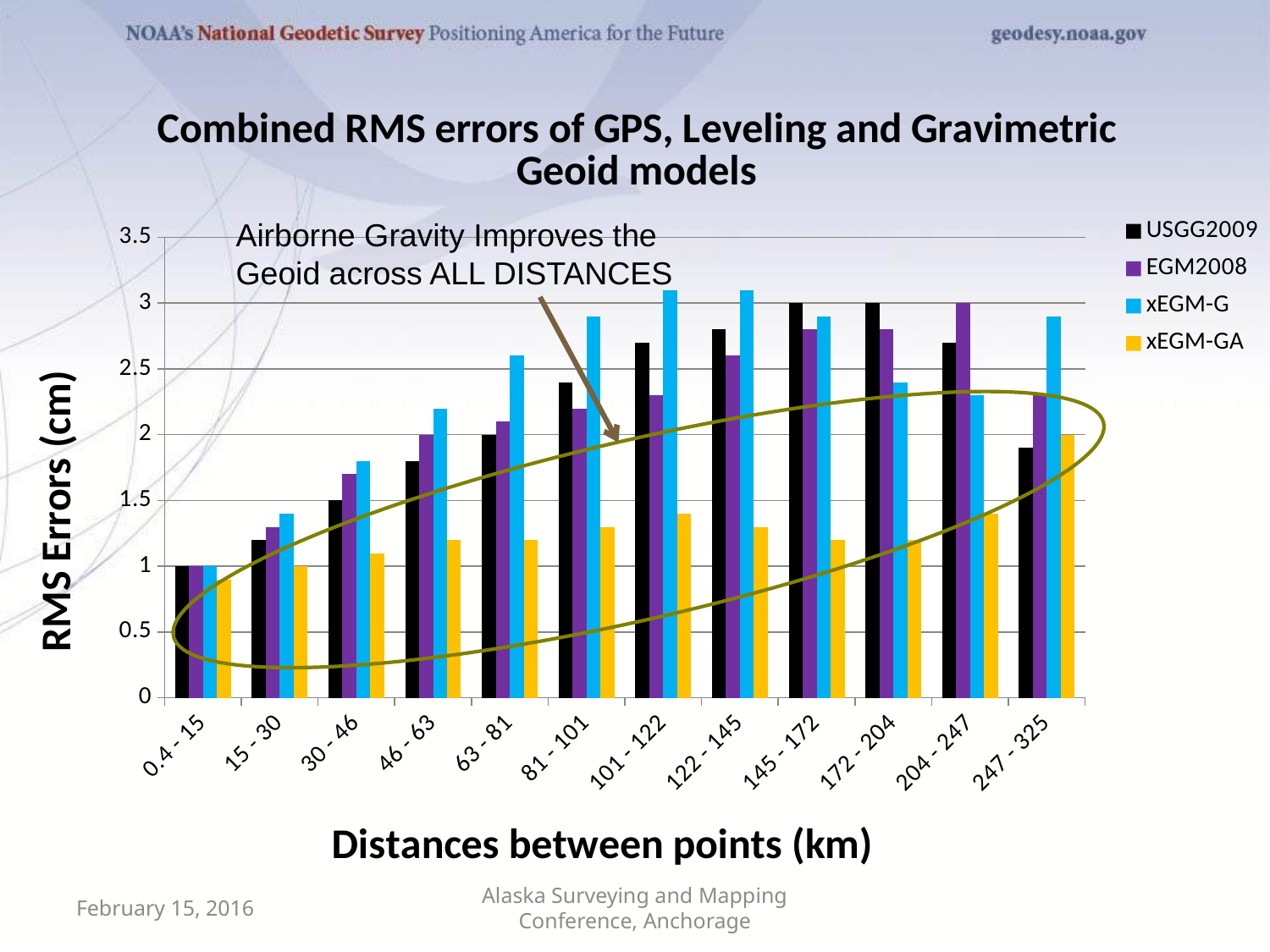
What kind of chart is shown on the slide? bar chart Which series is drawn in yellow? xEGM-GA Is the USGG2009 value for 101 - 122 km greater or less than 2.5? greater Which series has the lowest value in the 145 - 172 km category? xEGM-GA How many series does the legend list? 4 Is the xEGM-GA value for 145 - 172 km greater or less than 1.5? less How many distance categories are shown on the x axis? 12 Which is larger in the 172 - 204 km category, USGG2009 or xEGM-GA? USGG2009 Which series has the highest value in the 101 - 122 km category? xEGM-G What is the USGG2009 value for the 145 - 172 km category? 3 What is the label of the y axis? RMS Errors (cm) What is the xEGM-GA value for the 247 - 325 km category? 2